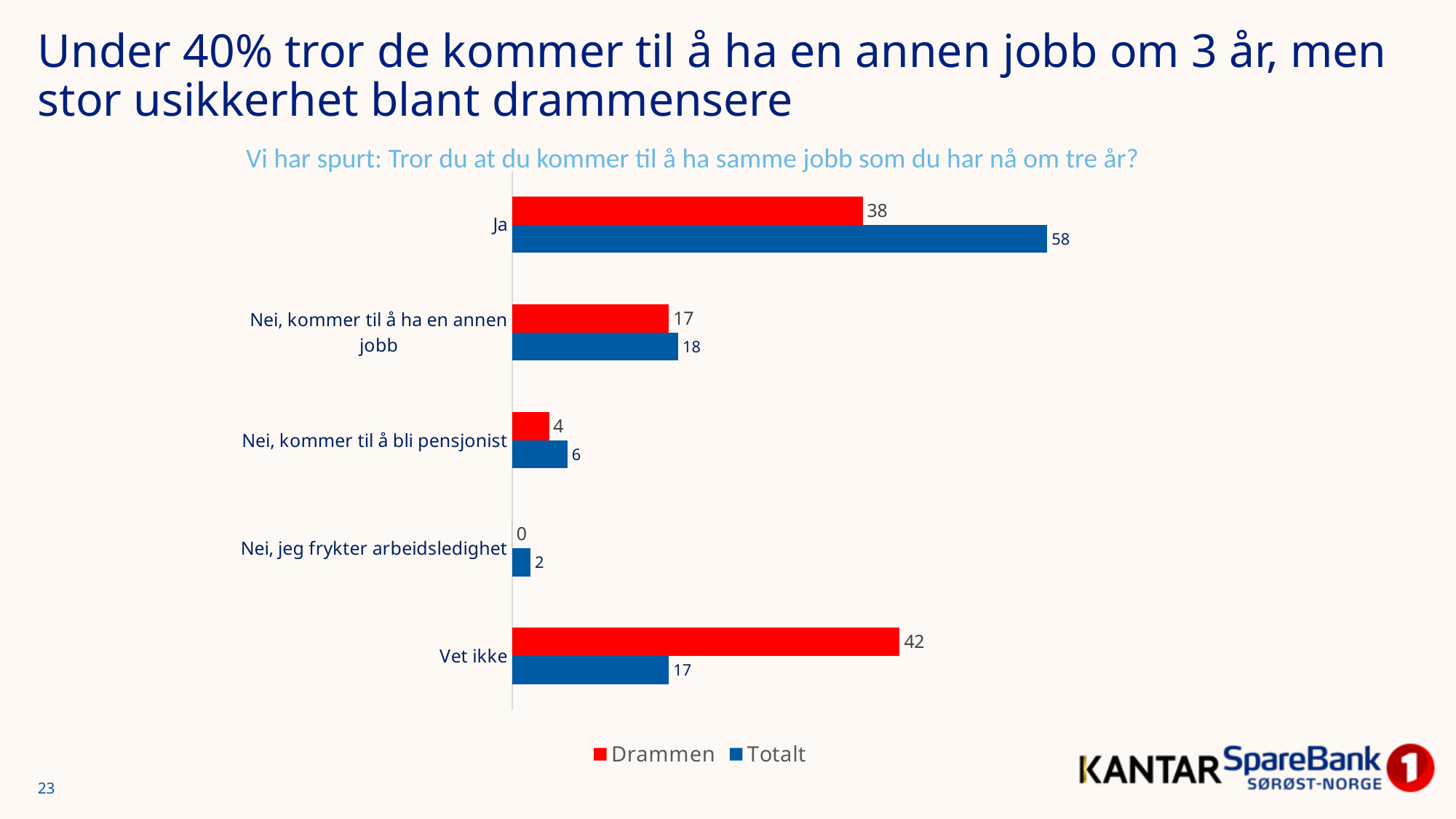
What is the Totalt value for "Ja"? 58 What is the Drammen value for "Vet ikke"? 42 Which category has the lowest Totalt value? Nei, jeg frykter arbeidsledighet How many categories are shown on the chart? 5 What is the Totalt value for "Nei, jeg frykter arbeidsledighet"? 2 What kind of chart is shown on the slide? Bar chart What is the Drammen value for "Ja"? 38 Which is larger for "Nei, kommer til å bli pensjonist": the Drammen value or the Totalt value? Totalt What is the difference between the Drammen and Totalt values for "Vet ikke"? 25 How many series does the legend list? 2 Which category has the highest Drammen value? Vet ikke What is the difference between the Totalt and Drammen values for "Ja"? 20